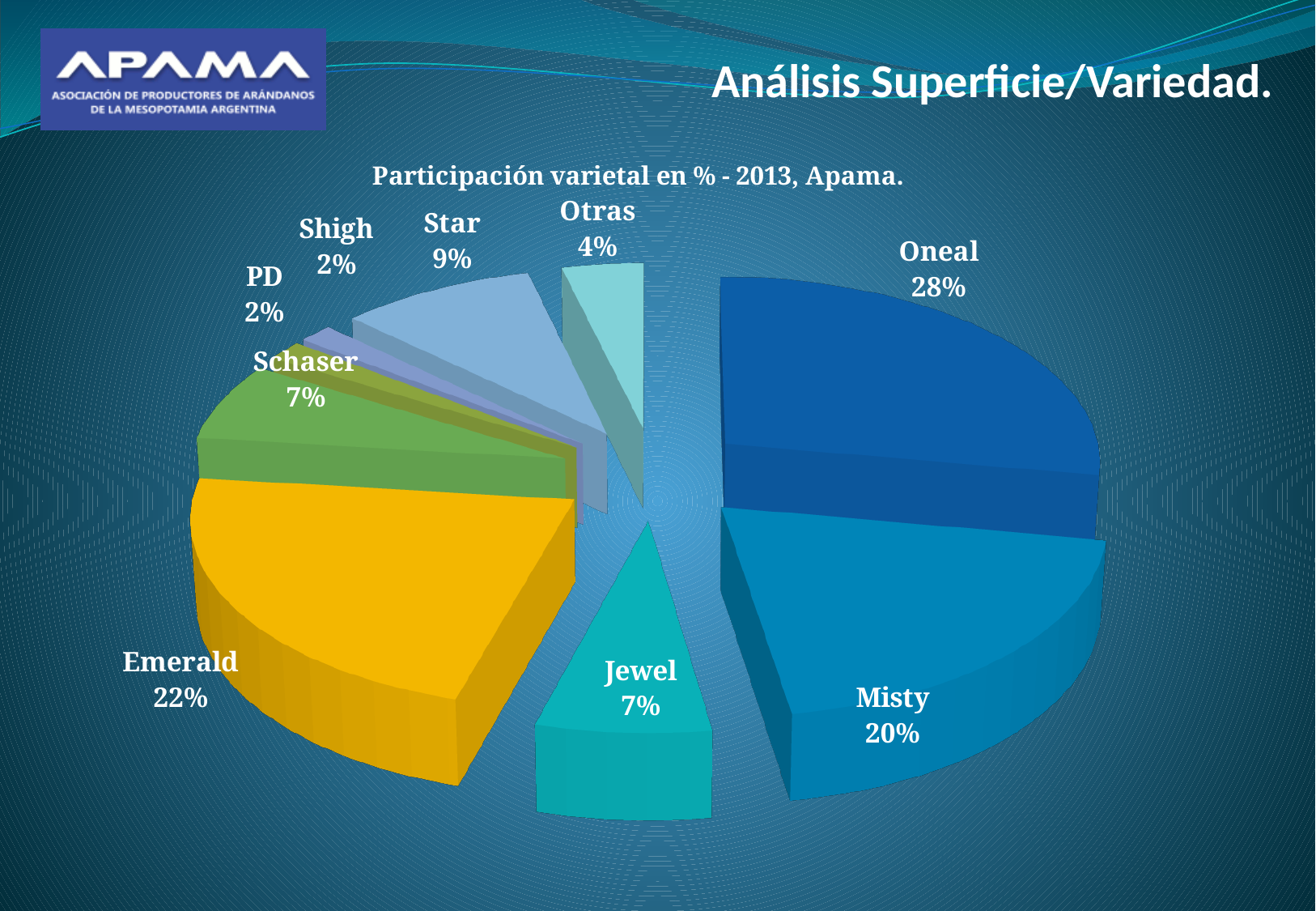
Which variety has the largest share of the pie? Oneal What kind of chart is shown on the slide? Pie chart What is the difference between the shares of Oneal and Misty? 8% Which two varieties each have a 2% share? Shigh and PD What share of the pie does Oneal have? 28% What is the value shown for Emerald? 22% What is the value for Otras? 4% How many slices does the pie chart have? 9 What is the combined share of Jewel and Schaser? 14% Which is larger, the share for Emerald or the share for Misty? Emerald What percentage is shown for Star? 9% What is the title of the chart? Participación varietal en % - 2013, Apama.